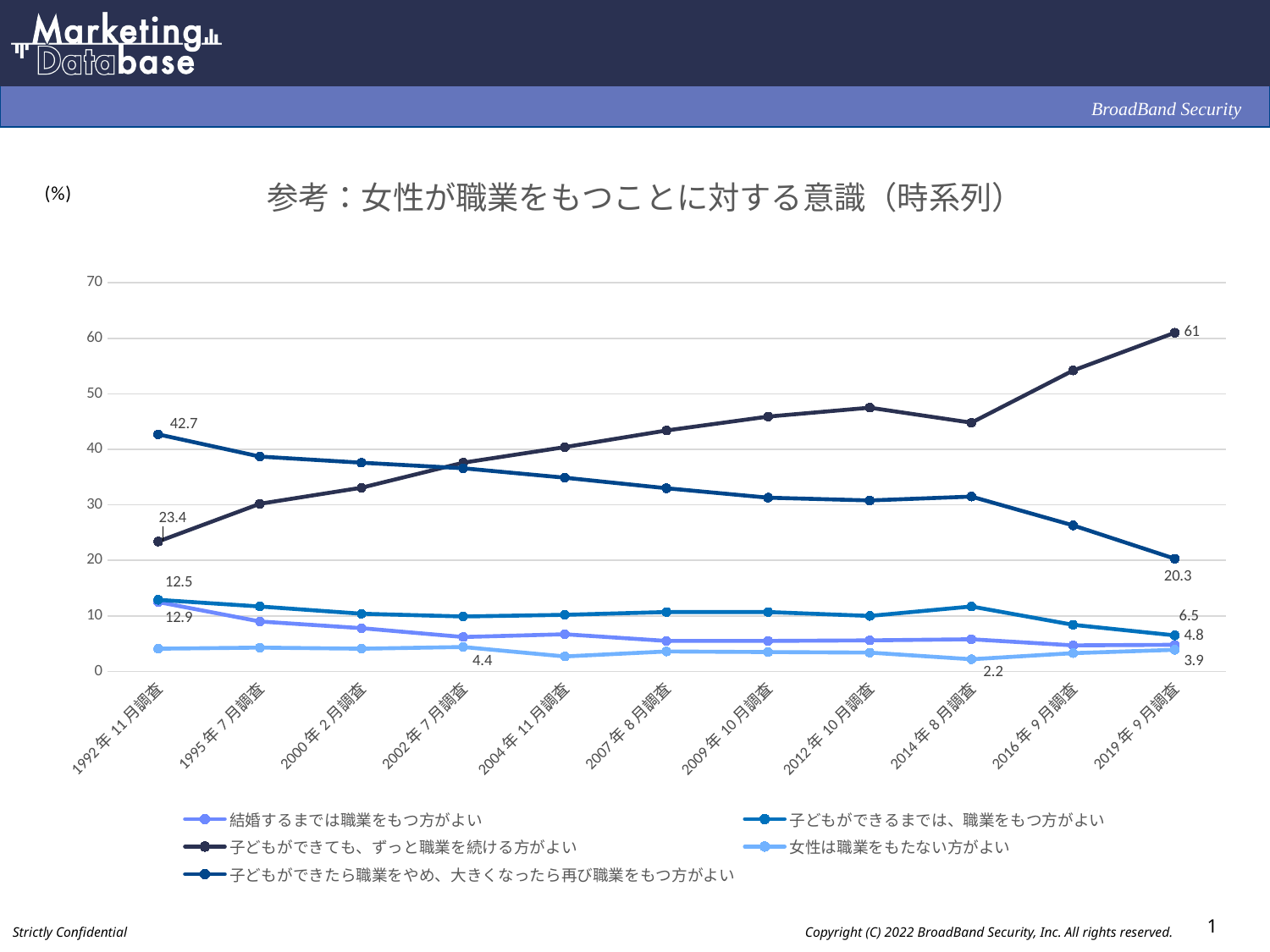
By how much did the value for 子どもができても、ずっと職業を続ける方がよい increase from the 1992年11月調査 to the 2019年9月調査? 37.6 Is the value for 子どもができたら職業をやめ、大きくなったら再び職業をもつ方がよい in the 2012年10月調査 greater or less than 40? less What is the value for 女性は職業をもたない方がよい in the 2014年8月調査? 2.2 What is the value for 子どもができたら職業をやめ、大きくなったら再び職業をもつ方がよい in the 1992年11月調査? 42.7 What is the value for 子どもができても、ずっと職業を続ける方がよい in the 2019年9月調査? 61 How many survey points are shown along the x axis? 11 Which series has the highest value in the 2019年9月調査? 子どもができても、ずっと職業を続ける方がよい How many series does the legend list? 5 What type of chart is shown on the slide? Line chart What is the value for 子どもができても、ずっと職業を続ける方がよい in the 1992年11月調査? 23.4 What is the value for 子どもができたら職業をやめ、大きくなったら再び職業をもつ方がよい in the 2019年9月調査? 20.3 By how much did the value for 子どもができたら職業をやめ、大きくなったら再び職業をもつ方がよい fall from the 1992年11月調査 to the 2019年9月調査? 22.4